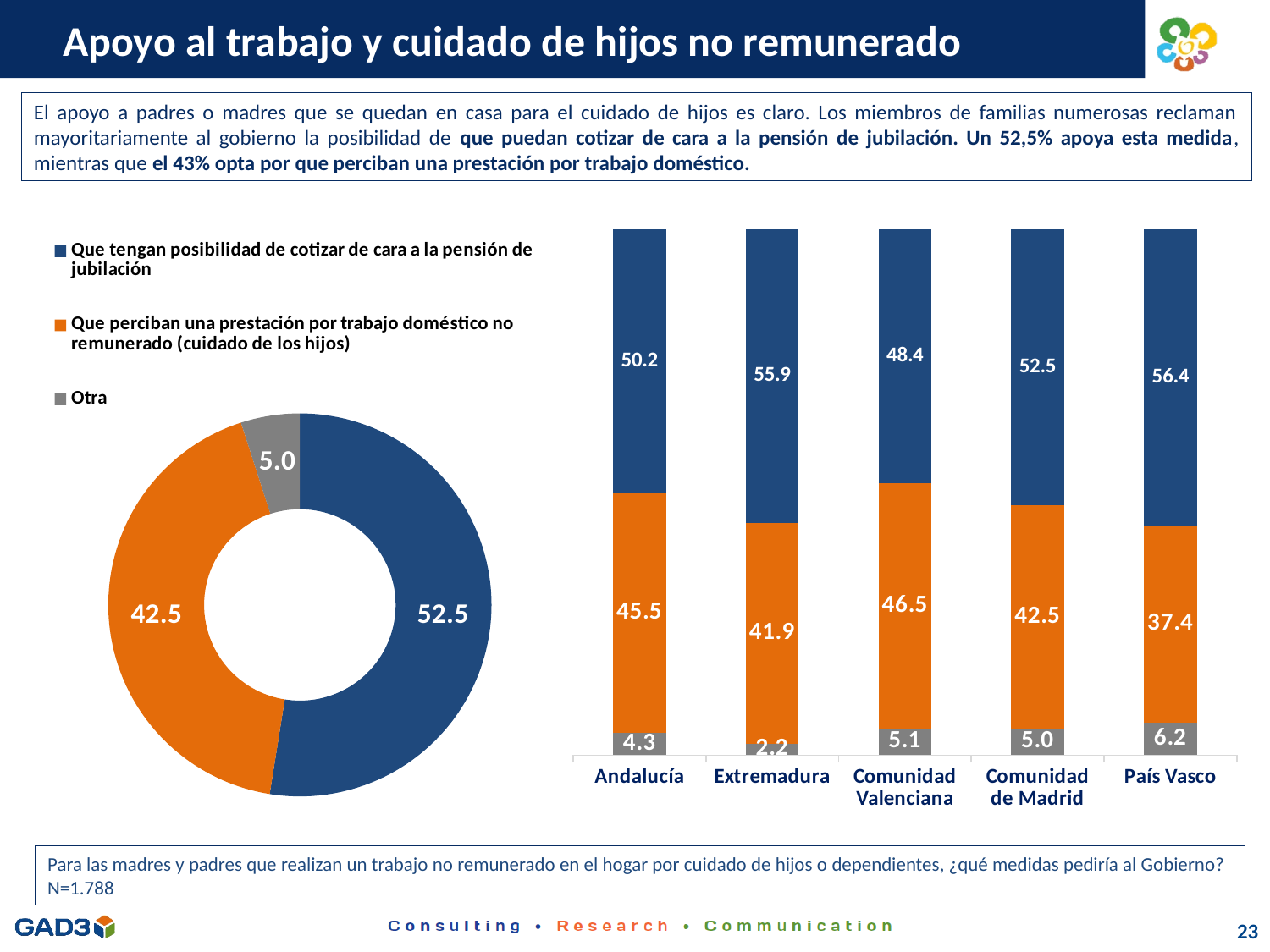
In the bar chart on the right, which is larger: the 'Que perciban una prestación por trabajo doméstico no remunerado' value for Andalucía or for Extremadura? Andalucía How many series does the legend list? 3 In the donut chart on the left, which category has the largest share? Que tengan posibilidad de cotizar de cara a la pensión de jubilación In the bar chart on the right, which region has the lowest value for 'Que perciban una prestación por trabajo doméstico no remunerado'? País Vasco In the bar chart on the right, what is the value for 'Que perciban una prestación por trabajo doméstico no remunerado' in Comunidad Valenciana? 46.5 In the donut chart on the left, what is the value for 'Otra'? 5.0 In the bar chart on the right, which region has the lowest value for 'Otra'? Extremadura In the bar chart on the right, what is the value for 'Otra' in Extremadura? 2.2 In the bar chart on the right, what is the value for 'Que tengan posibilidad de cotizar de cara a la pensión de jubilación' in País Vasco? 56.4 How many regions are shown on the x axis of the bar chart on the right? 5 In the bar chart on the right, what is the difference between the 'Otra' values for País Vasco and Andalucía? 1.9 In the bar chart on the right, which region has the highest value for 'Que tengan posibilidad de cotizar de cara a la pensión de jubilación'? País Vasco